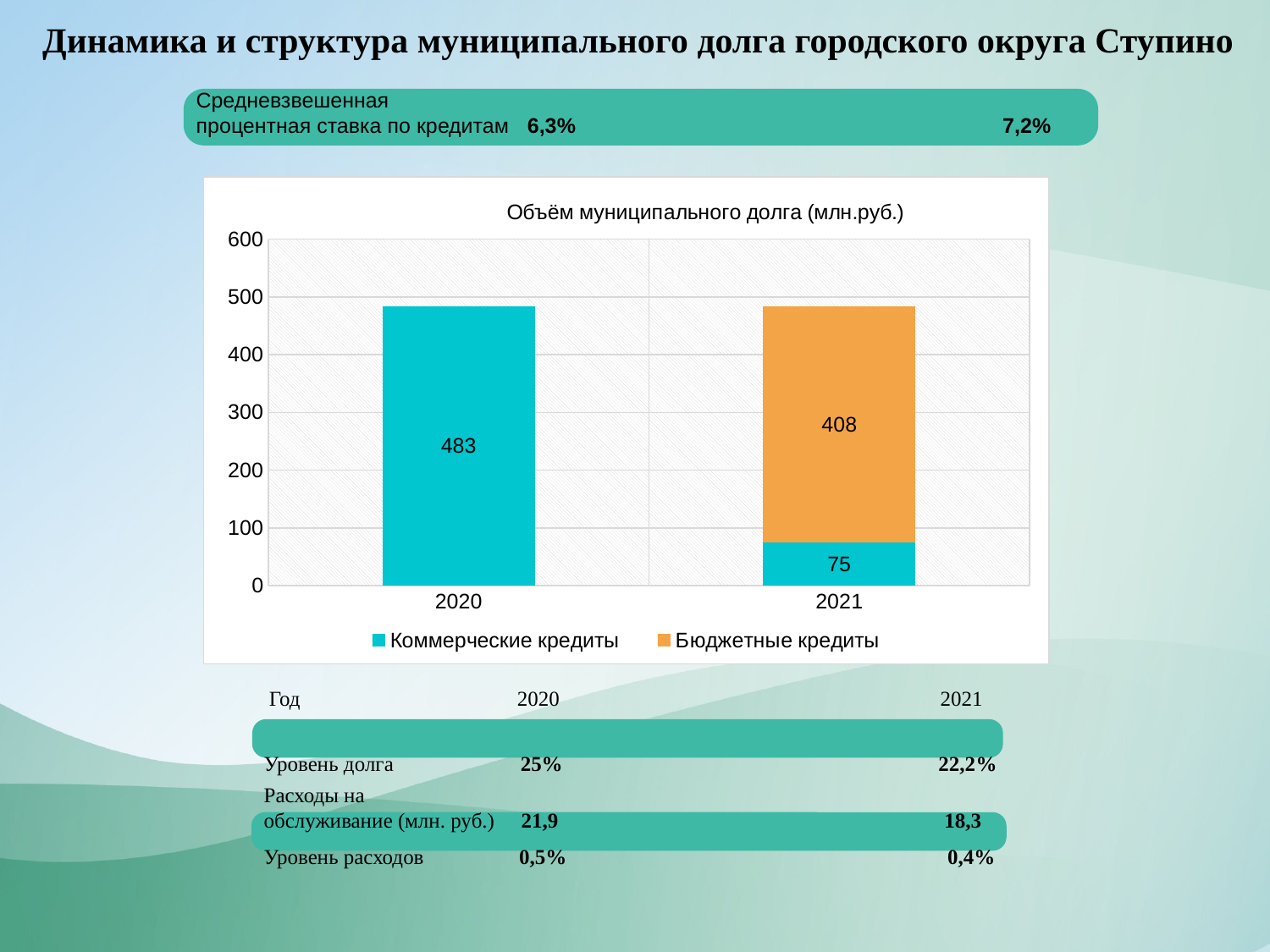
What is the value of Коммерческие кредиты for 2020? 483 What kind of chart is shown on the slide? stacked bar chart How many series does the chart legend list? 2 What is the title of the chart? Объём муниципального долга (млн.руб.) By how much did Коммерческие кредиты fall from 2020 to 2021? 408 What is the value of Бюджетные кредиты for 2021? 408 Is the value of Коммерческие кредиты for 2021 greater or less than 100? less Which is larger in 2021, Коммерческие кредиты or Бюджетные кредиты? Бюджетные кредиты What is the difference between Бюджетные кредиты and Коммерческие кредиты in 2021? 333 What is the total of the stacked bar for 2021? 483 How many years are shown on the x axis of the chart? 2 What is the value of Коммерческие кредиты for 2021? 75